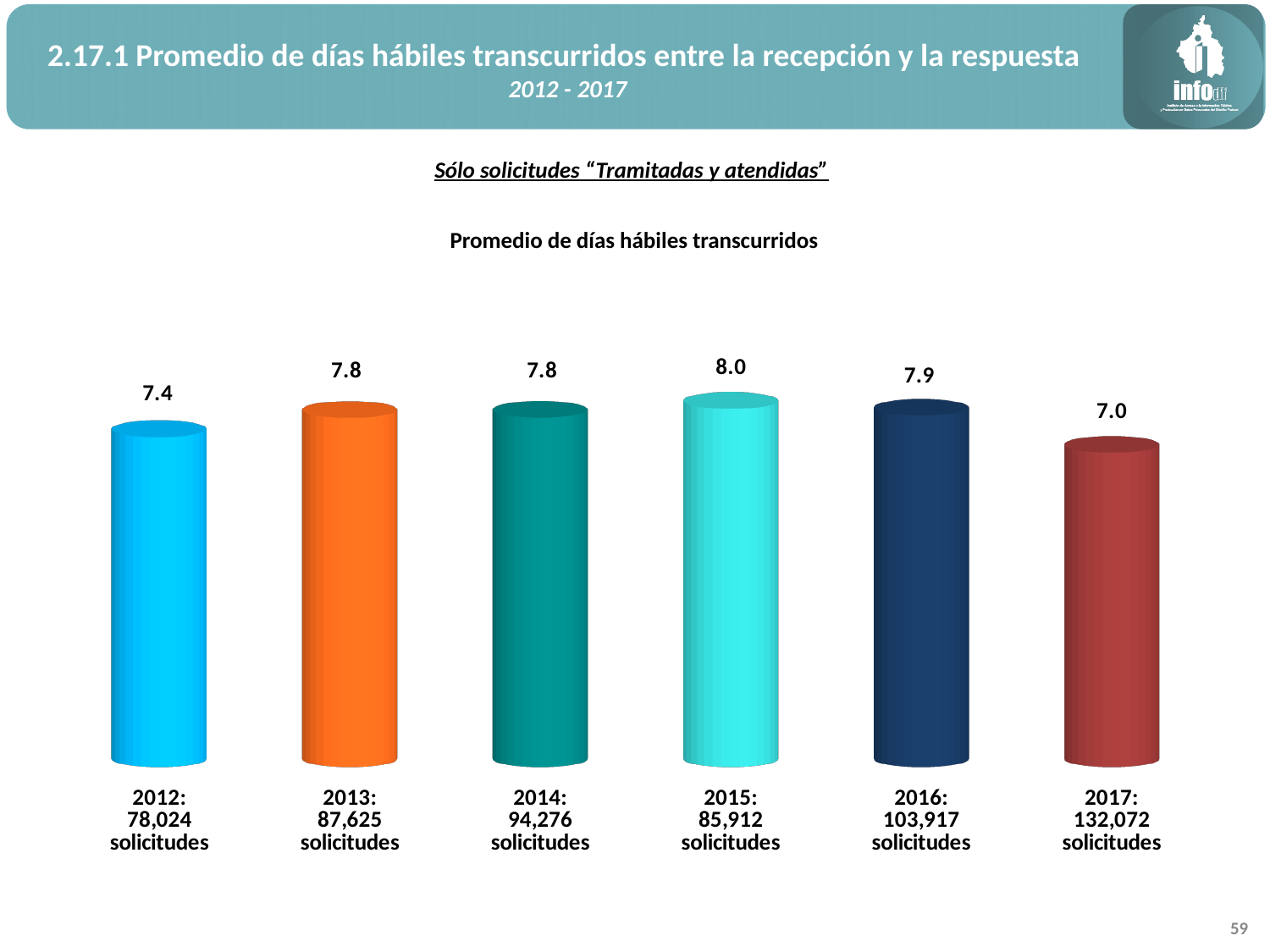
Do the values rise or fall from 2015 to 2017? Fall Which year has the lowest average number of business days? 2017 What is the average number of business days (promedio de días hábiles transcurridos) for 2012? 7.4 How many years (bars) are shown in the chart? 6 What kind of chart is shown on the slide? Bar chart How many solicitudes are listed under the 2017 bar? 132,072 solicitudes Which is larger, the average for 2016 or the average for 2012? 2016 What is the difference between the average for 2015 and the average for 2017? 1.0 Which year has the highest average number of business days? 2015 What is the average number of business days shown for 2017? 7.0 What is the title printed above the chart? Promedio de días hábiles transcurridos What is the average number of business days shown for 2015? 8.0